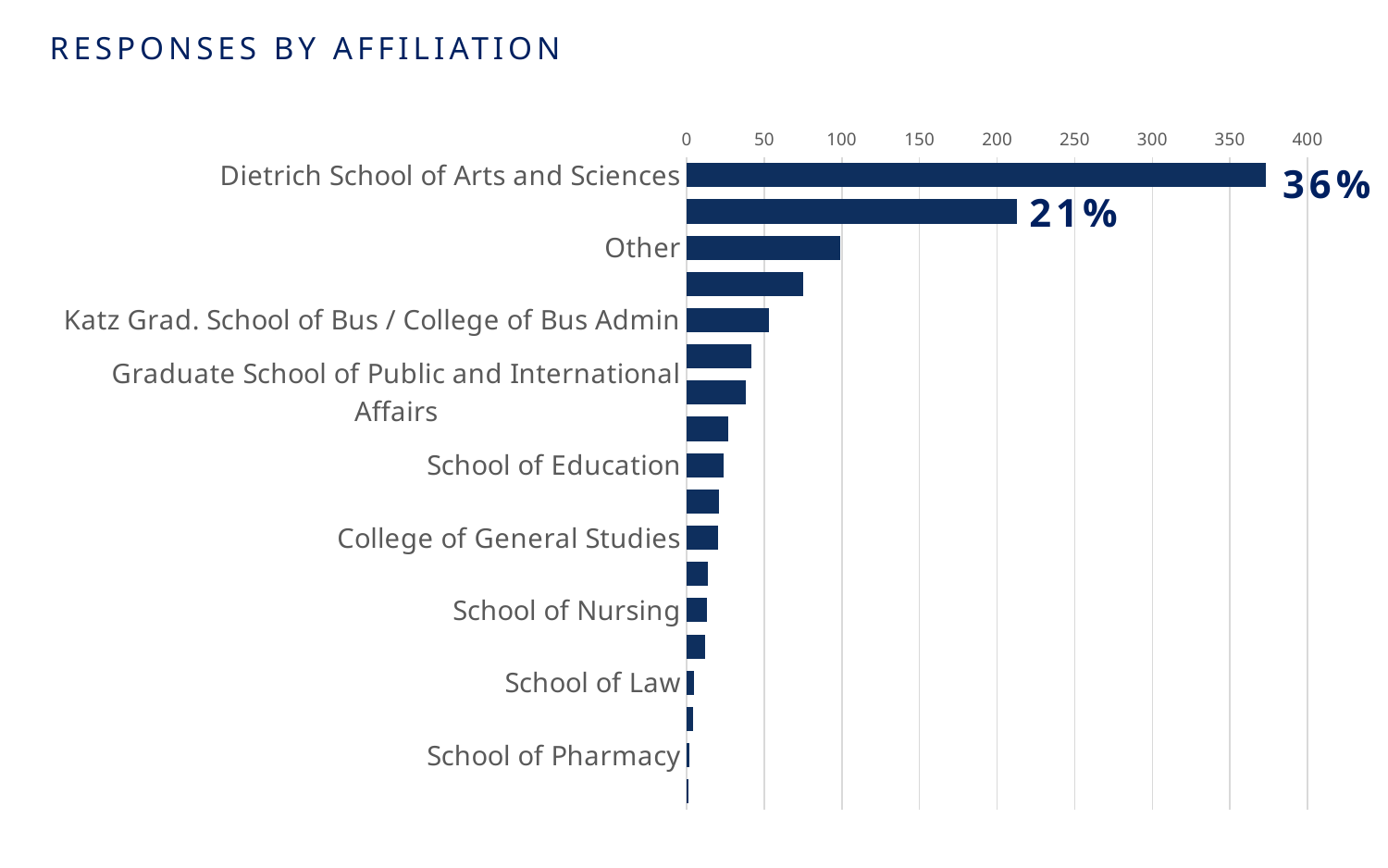
What kind of chart is shown on the slide? bar chart What is the title of the chart? RESPONSES BY AFFILIATION What percentage label is shown next to the second-longest bar? 21% Is the value for School of Law greater or less than 50? less What percentage label is shown next to the bar for Dietrich School of Arts and Sciences? 36% Which has more responses, Katz Grad. School of Bus / College of Bus Admin or School of Education? Katz Grad. School of Bus / College of Bus Admin Is the value for Dietrich School of Arts and Sciences greater or less than 350? greater Do the bar values increase or decrease going from the top of the chart to the bottom? decrease Is the value for Other greater or less than 150? less How many bars are plotted in the chart? 18 Which affiliation has the highest number of responses? Dietrich School of Arts and Sciences